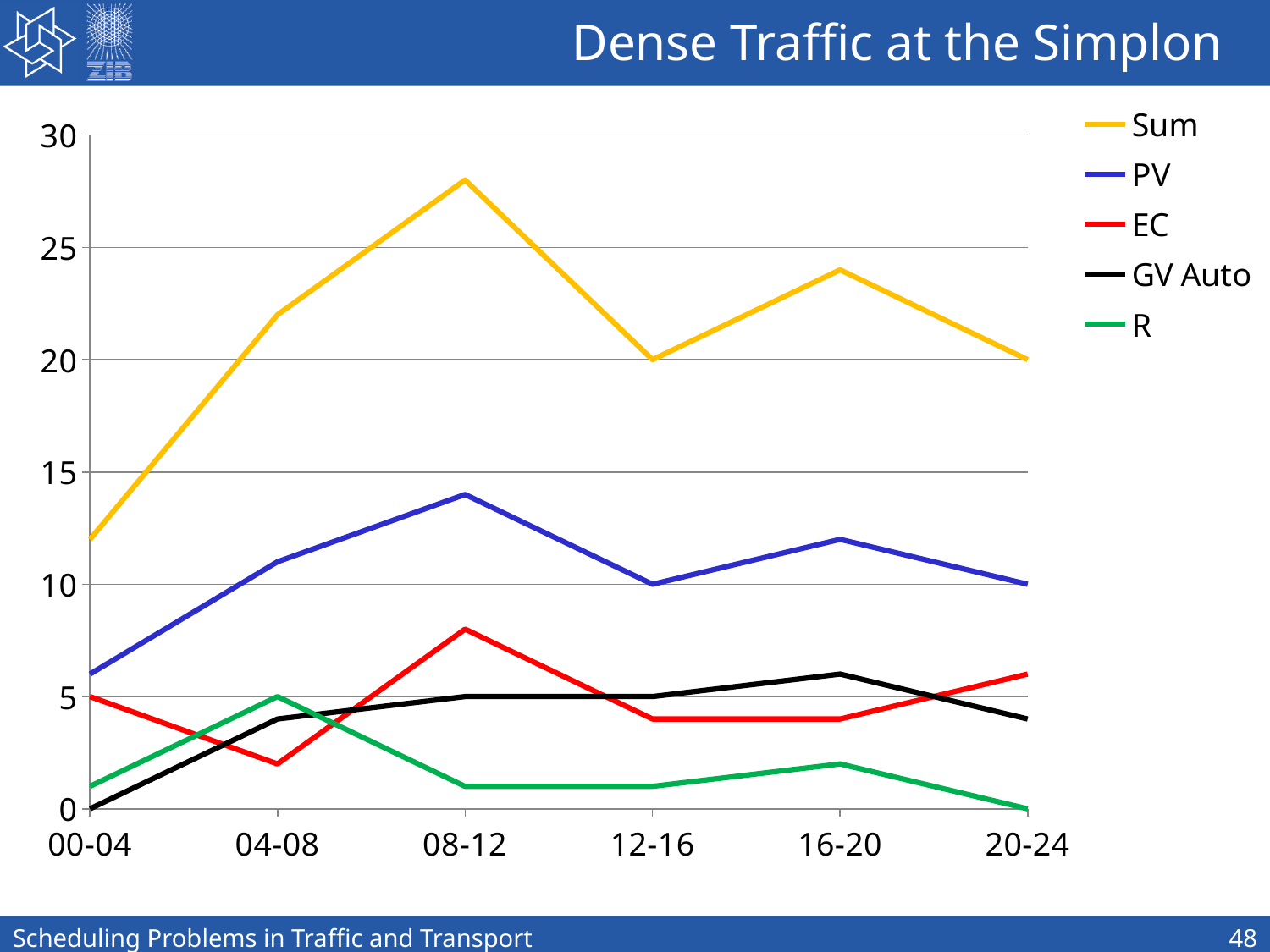
Which is larger in the 08-12 period, PV or EC? PV What is the value of PV for the 20-24 period? 10 How many series does the legend list? 5 What kind of chart is shown on the slide? line chart What is the value of R for the 04-08 period? 5 What is the value of Sum for the 12-16 period? 20 In which time period is R at its lowest value? 20-24 In which time period does Sum reach its highest value? 08-12 What is the value of GV Auto for the 00-04 period? 0 Does the Sum line rise or fall from 16-20 to 20-24? fall How many time periods are shown on the x axis? 6 Is the value of Sum for the 08-12 period greater or less than 25? greater